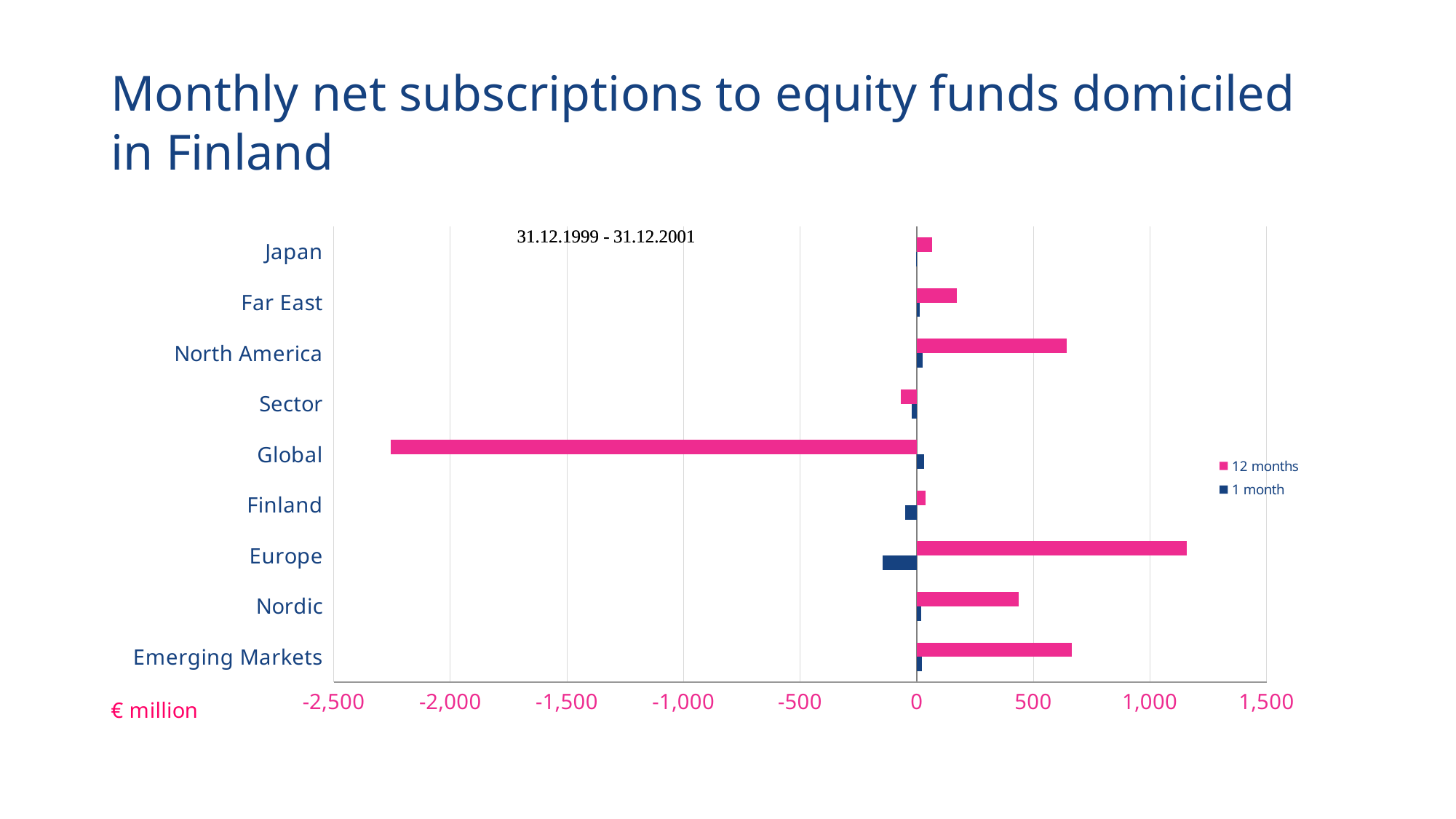
Which category has the lowest 12 months value? Global Which category has the highest 12 months value? Europe Which has the larger 12 months value, Europe or Nordic? Europe Is the 12 months value for Global greater or less than -2,000? less Is the 12 months value for Europe greater or less than 1,000? greater Is the 12 months value for North America greater or less than 500? greater What kind of chart is shown on the slide? bar chart Which has the larger 1 month value, Global or Europe? Global How many categories are shown on the chart? 9 How many series does the legend list? 2 What unit is shown below the x axis? € million